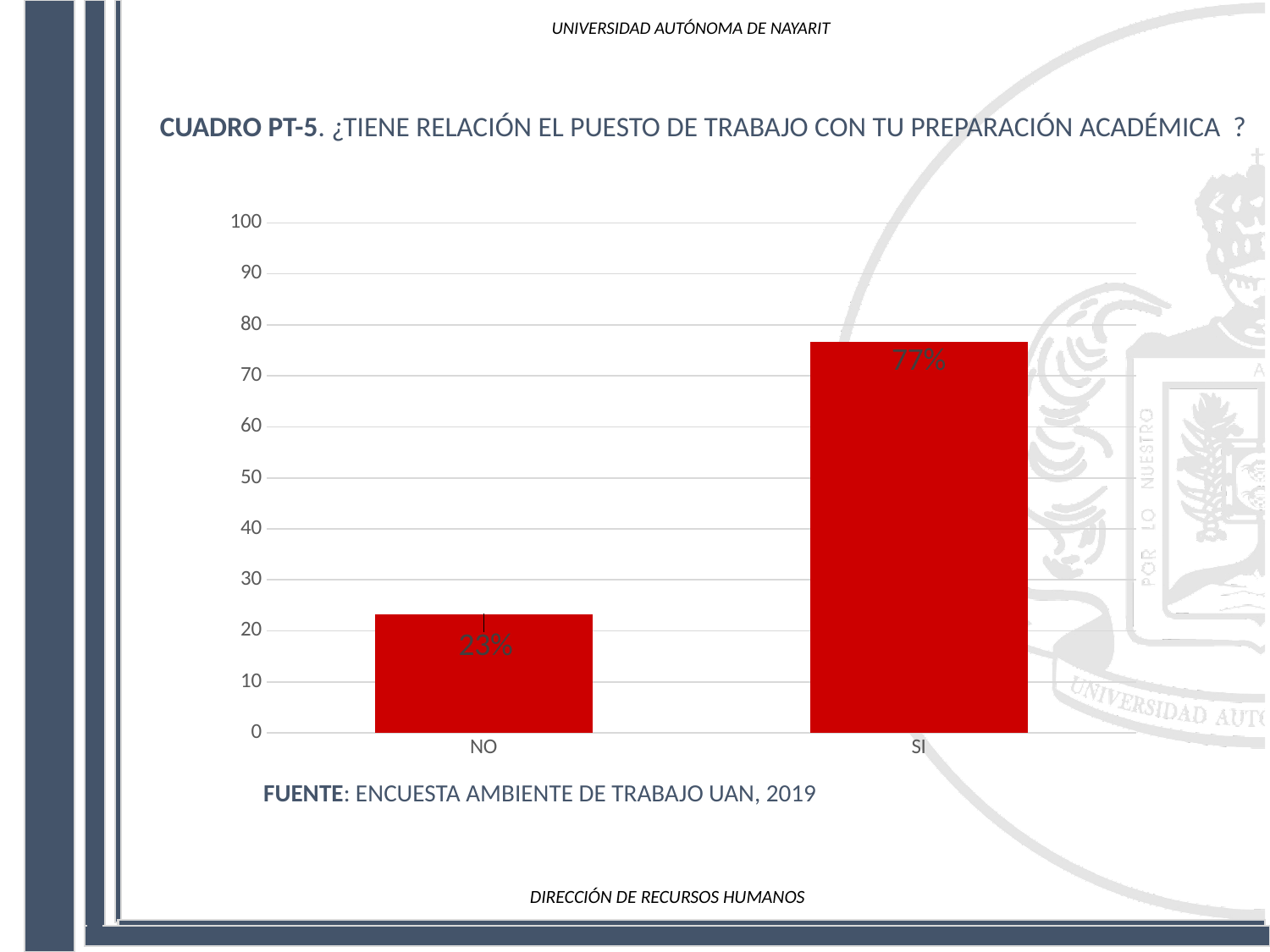
What is the value for NO? 23% How many categories are shown on the x axis? 2 Is the value for NO greater or less than 30? less What kind of chart is shown on the slide? bar chart What is the value for SI? 77% Which category has the highest value? SI Which is larger, the value for NO or the value for SI? SI Is the value for SI greater or less than 70? greater What colour are the bars in the chart? red What is the difference between the values for SI and NO? 54% Which category has the lowest value? NO What is the source cited below the chart? ENCUESTA AMBIENTE DE TRABAJO UAN, 2019